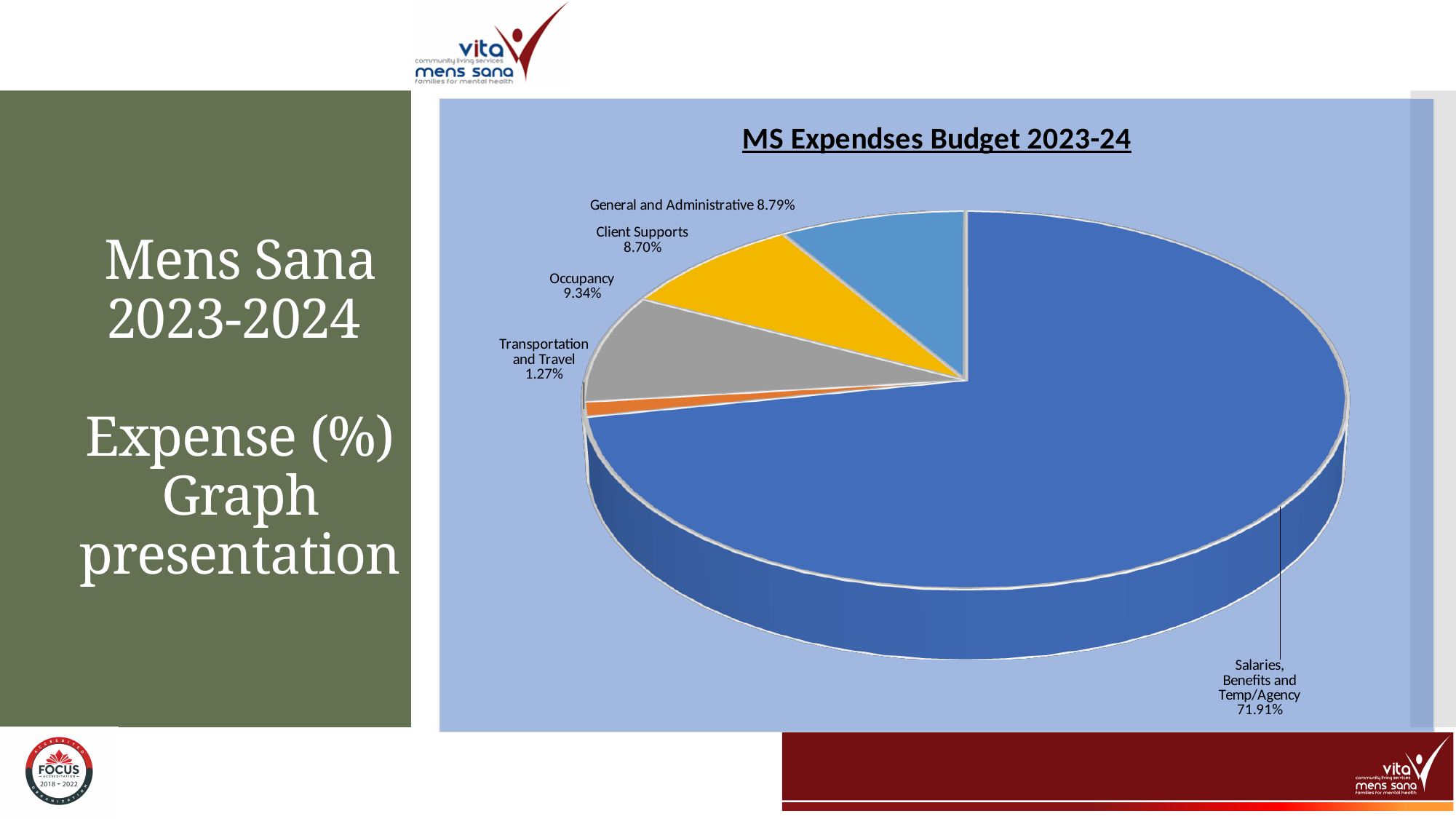
Which category has the largest slice in the pie chart? Salaries, Benefits and Temp/Agency What is the title of the chart on the slide? MS Expendses Budget 2023-24 What percentage is labelled for Client Supports in the pie chart? 8.70% What percentage does the Occupancy slice represent in the pie chart? 9.34% What kind of chart is shown on the slide? Pie chart What share of the pie chart is Transportation and Travel? 1.27% Which is larger in the pie chart, Occupancy or Transportation and Travel? Occupancy Which category has the smallest slice in the pie chart? Transportation and Travel How many slices does the pie chart have? 5 What share of the MS Expendses Budget 2023-24 pie chart is Salaries, Benefits and Temp/Agency? 71.91% What is the difference in percentage points between Salaries, Benefits and Temp/Agency and Occupancy? 62.57% What is the value shown for General and Administrative in the pie chart? 8.79%